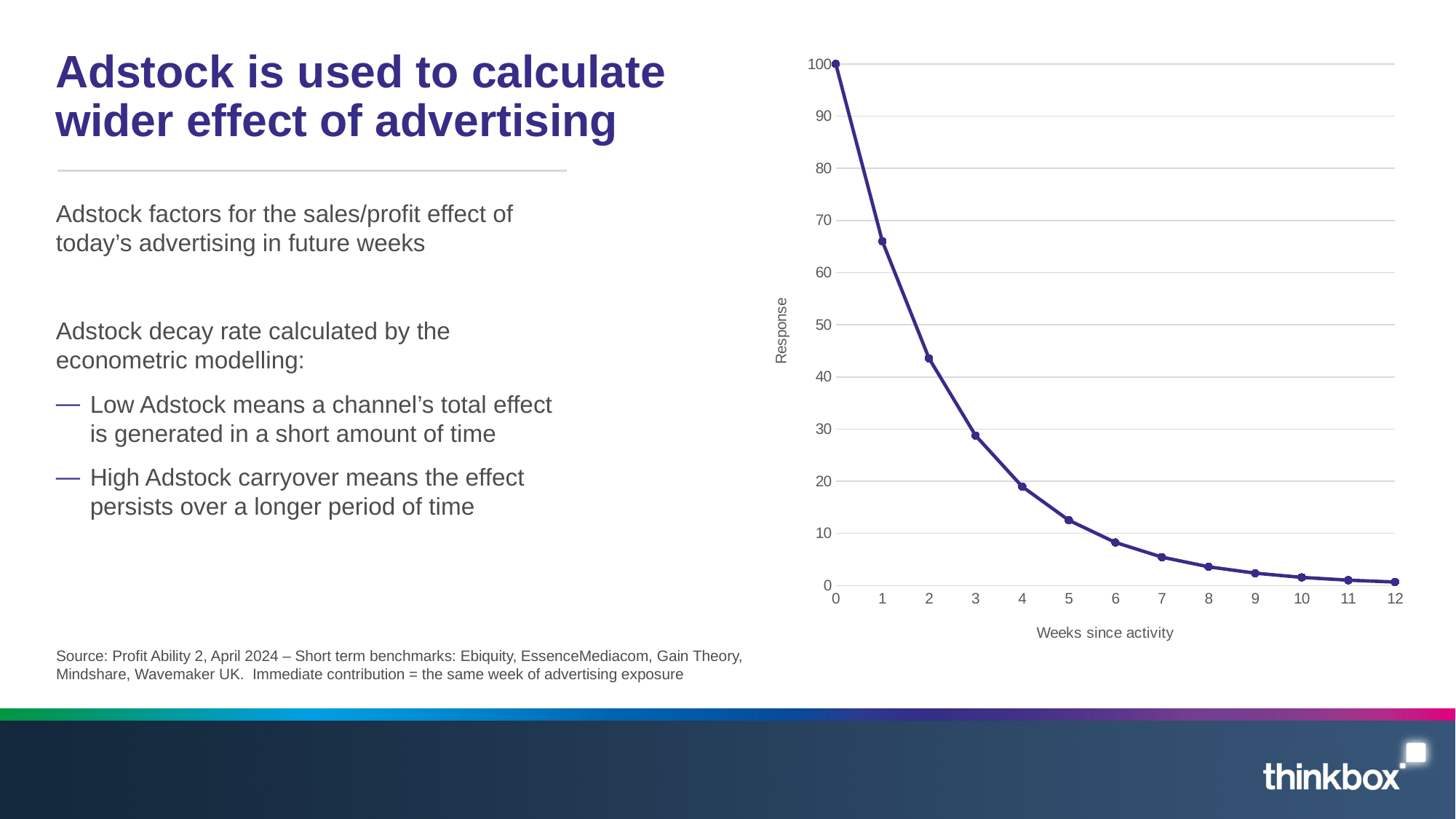
At which week is the response lowest? 12 What kind of chart is shown on the slide? line chart Is the response at week 6 greater or less than 10? less What is the label on the x axis of the chart? Weeks since activity What is the response value at week 0? 100 How many data points are plotted on the line? 13 Is the response at week 2 greater or less than 50? less At which week is the response highest? 0 Is the response at week 1 greater or less than 60? greater Do the values rise or fall as the weeks since activity increase? fall Which has the larger response, week 1 or week 2? week 1